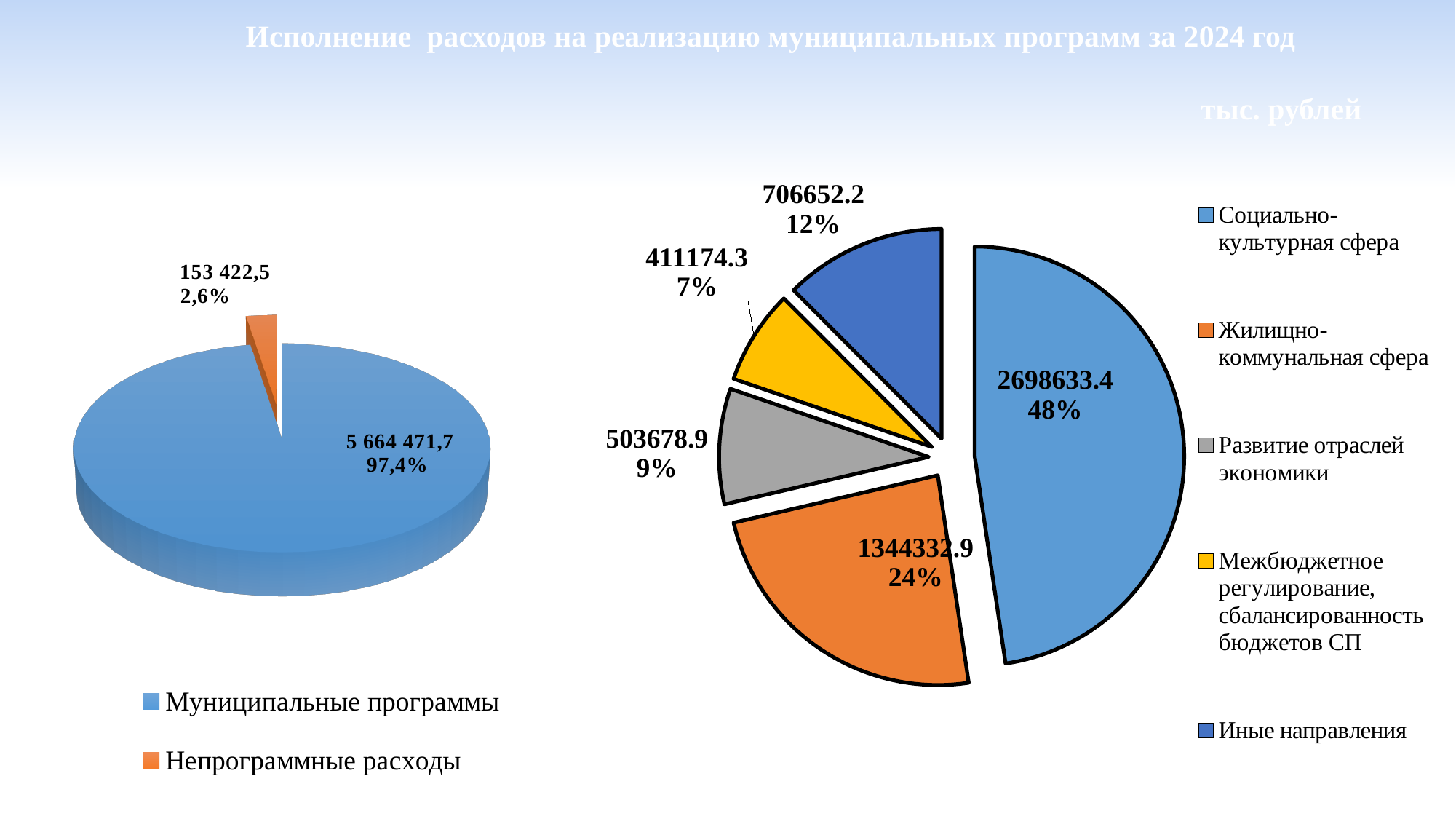
On the right pie chart, which category has the smallest slice? Межбюджетное регулирование, сбалансированность бюджетов СП What kind of chart is the chart on the left of the slide? Pie chart On the right pie chart, how many categories does the legend list? 5 On the right pie chart, which is larger: Иные направления or Развитие отраслей экономики? Иные направления On the right pie chart, what is the value for Иные направления? 706652.2 On the right pie chart, what colour is the slice for Межбюджетное регулирование, сбалансированность бюджетов СП? Yellow On the right pie chart, what is the value for Жилищно-коммунальная сфера? 1344332.9 On the left pie chart, what is the value for Муниципальные программы? 5 664 471,7 On the left pie chart, what share of the pie does Непрограммные расходы take? 2,6% On the right pie chart, what share of the pie does Развитие отраслей экономики take? 9% On the left pie chart, how many slices are there? 2 On the right pie chart, which category has the largest slice? Социально-культурная сфера